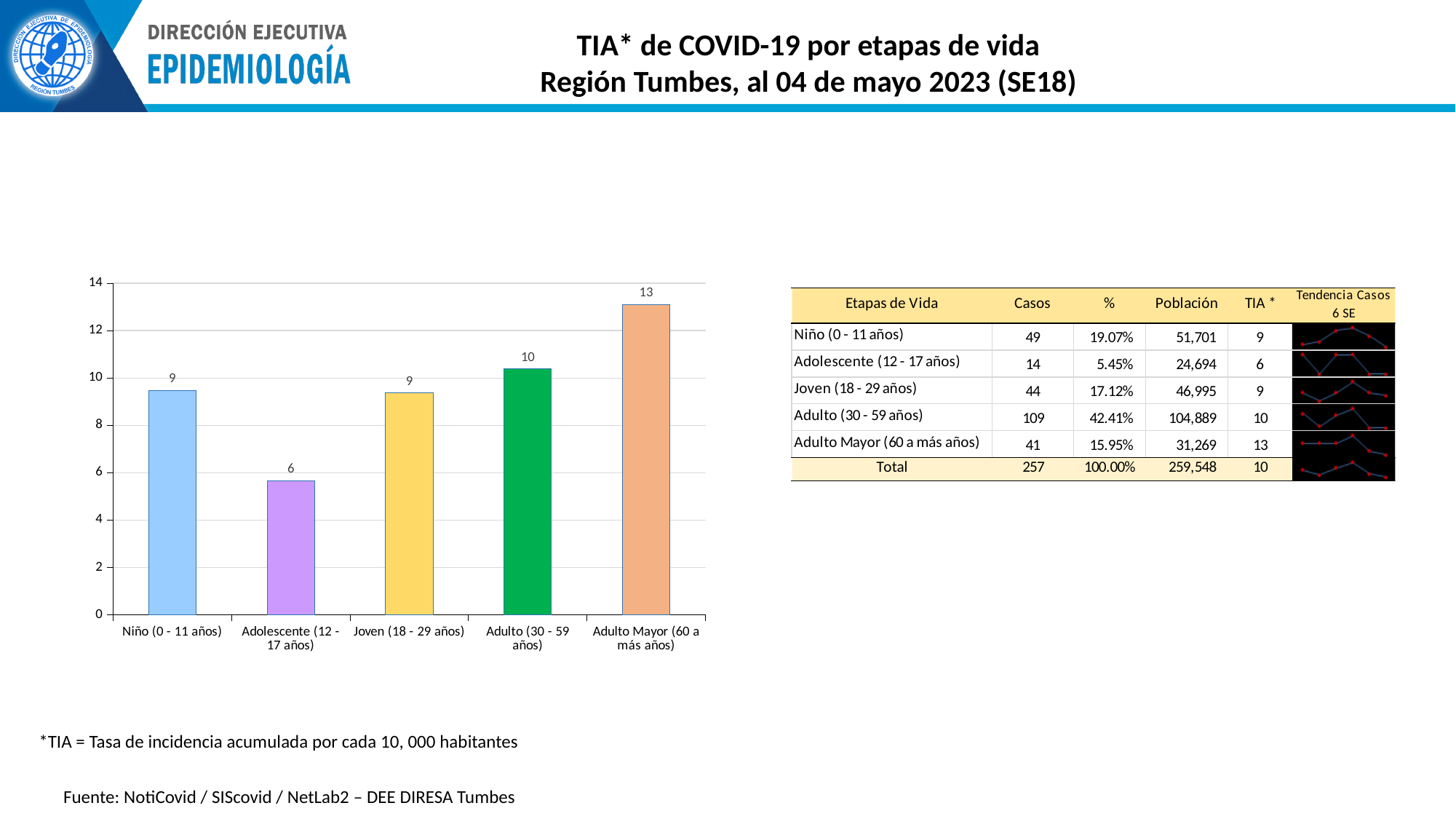
Which life stage has the highest TIA in the bar chart? Adulto Mayor (60 a más años) What is the difference between the TIA for Adulto Mayor (60 a más años) and Adolescente (12 - 17 años)? 7 What is the maximum value shown on the vertical axis of the bar chart? 14 What is the TIA value shown for Adulto (30 - 59 años) in the bar chart? 10 What kind of chart is used to show the TIA by life stage? Bar chart Is the value for Adulto Mayor (60 a más años) greater or less than 12? greater What is the TIA value shown for Adulto Mayor (60 a más años) in the bar chart? 13 How many life-stage categories are shown in the bar chart? 5 Which has a larger TIA in the bar chart, Adulto (30 - 59 años) or Adolescente (12 - 17 años)? Adulto (30 - 59 años) Is the value for Adolescente (12 - 17 años) greater or less than 8? less Which life stage has the lowest TIA in the bar chart? Adolescente (12 - 17 años) What is the TIA value shown for Adolescente (12 - 17 años) in the bar chart? 6